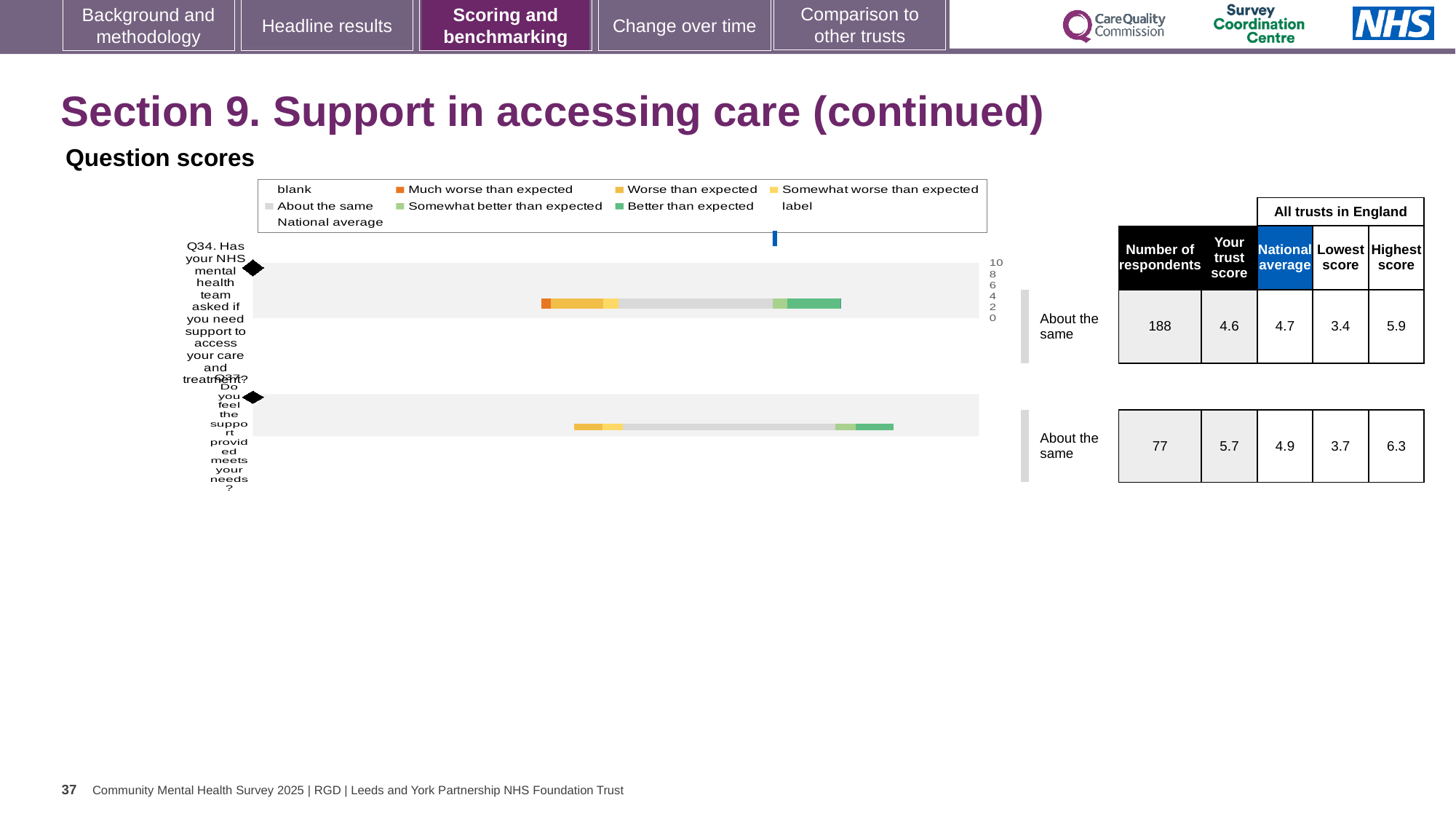
How many questions are plotted in the question scores chart? 2 What benchmark category is shown for Q34? About the same Which question has the higher number of respondents, Q34 or Q37? Q34 What is the national average score for Q37? 4.9 How many respondents answered Q34? 188 What is the difference between the highest and lowest scores across all trusts in England for Q34? 2.5 What kind of chart is used to show the question scores on this slide? bar chart What is the difference between the highest and lowest scores across all trusts in England for Q37? 2.6 What is the trust score for Q37 (Do you feel the support provided meets your needs)? 5.7 For Q37, which is larger: the trust score or the national average? the trust score What is the lowest score across all trusts in England for Q34? 3.4 What is the trust score for Q34 (Has your NHS mental health team asked if you need support to access your care and treatment)? 4.6